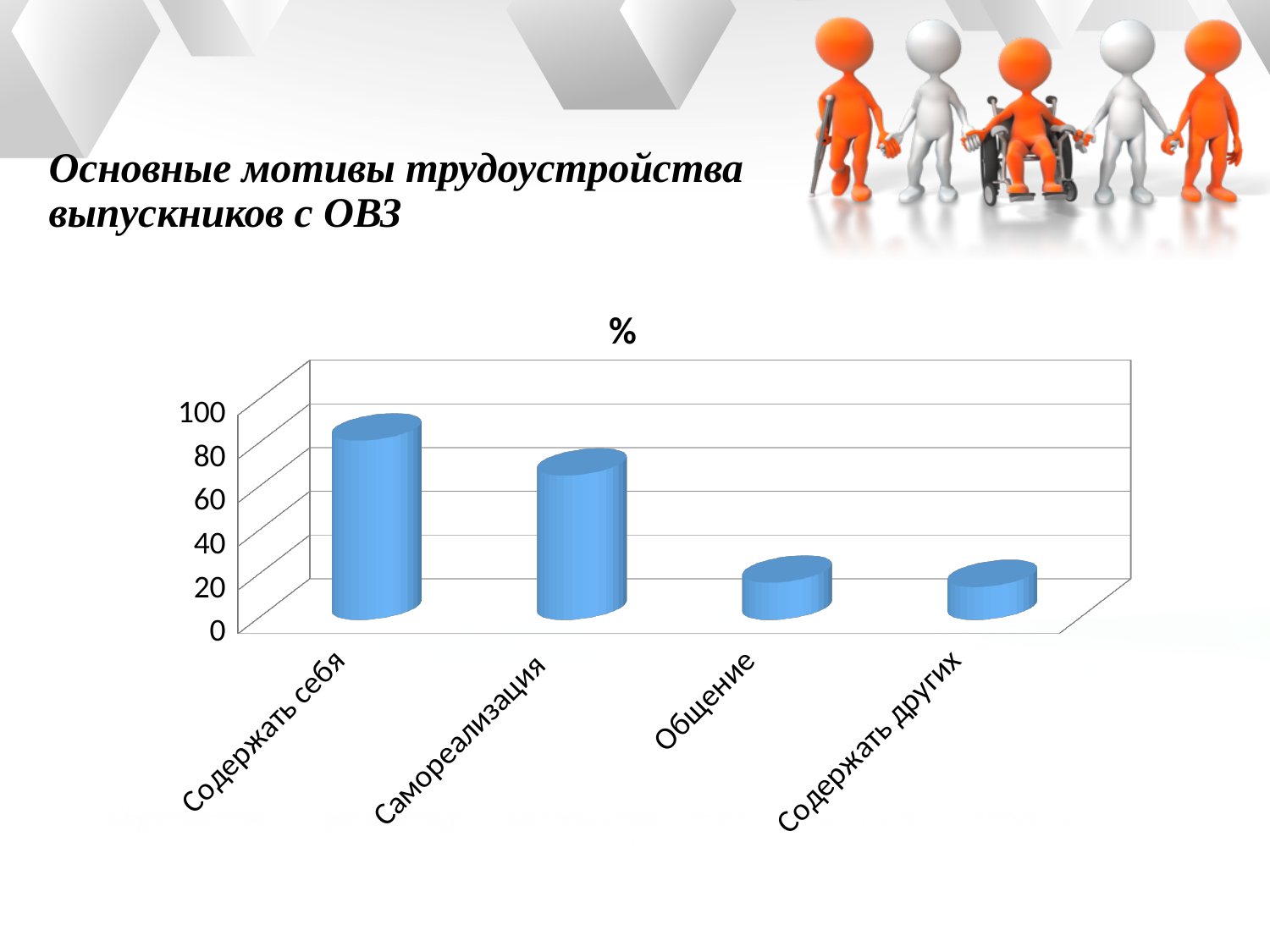
What colour are the bars in the chart? blue Is the value for Общение greater or less than 40? less Which is larger, the value for Содержать себя or the value for Самореализация? Содержать себя Which category has the highest value in the chart? Содержать себя Is the value for Самореализация greater or less than 60? greater Is the value for Содержать других greater or less than 40? less What is the title of the chart? % Do the values generally rise or fall from left to right along the x axis? fall How many categories are shown on the x axis of the chart? 4 What kind of chart is shown on the slide? bar chart Which is larger, the value for Самореализация or the value for Общение? Самореализация